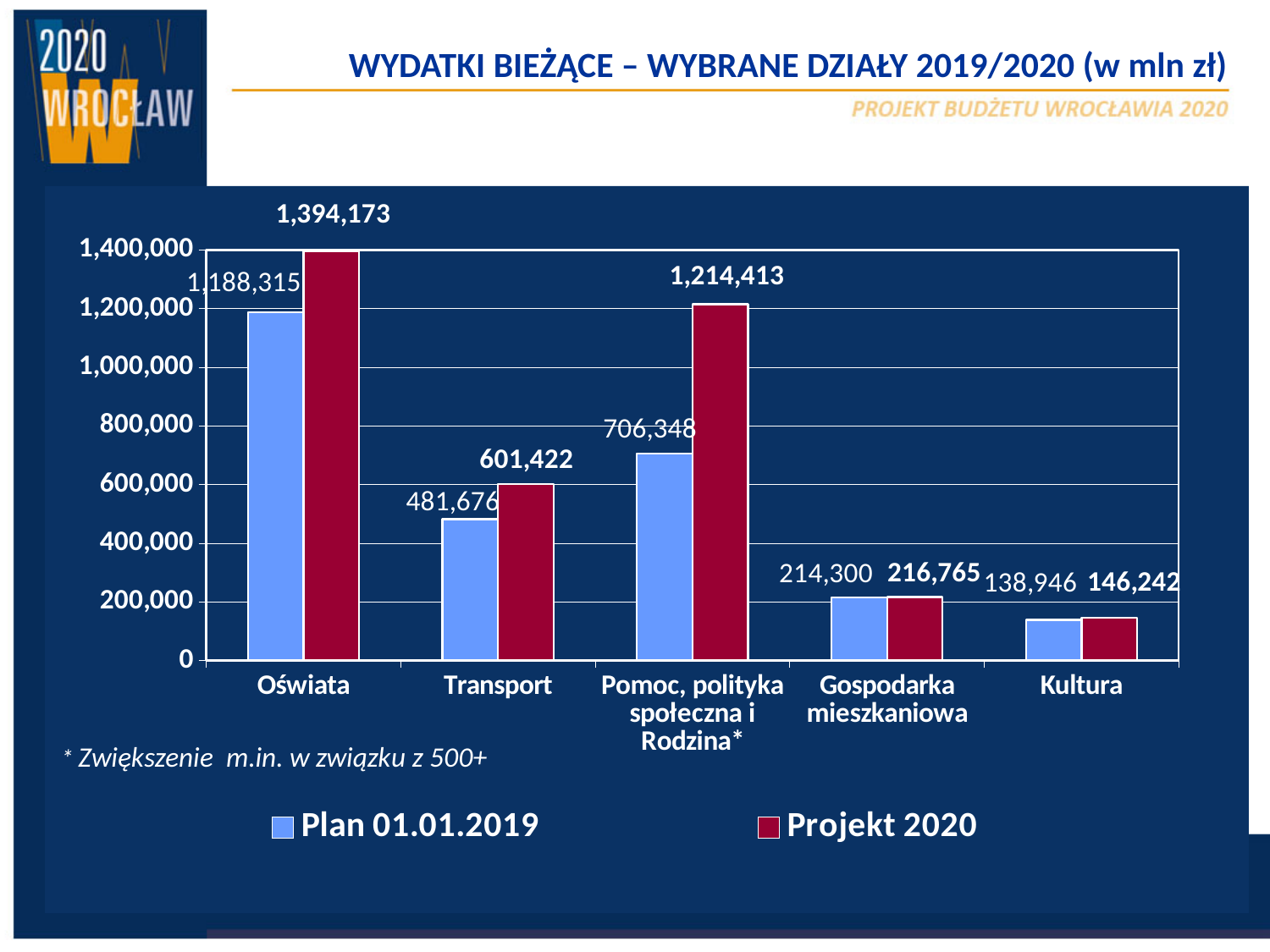
What is the difference between the Projekt 2020 and Plan 01.01.2019 values for Transport? 119,746 How many categories are shown on the x axis? 5 How many series does the legend list? 2 Which category has the highest Projekt 2020 value? Oświata What is the Plan 01.01.2019 value for Transport? 481,676 What kind of chart is shown on the slide? Bar chart What is the Plan 01.01.2019 value for Kultura? 138,946 What is the Projekt 2020 value for Oświata? 1,394,173 What is the Projekt 2020 value for Pomoc, polityka społeczna i Rodzina*? 1,214,413 Which category has the lowest Plan 01.01.2019 value? Kultura Which is larger: the Plan 01.01.2019 value for Transport or the Plan 01.01.2019 value for Pomoc, polityka społeczna i Rodzina*? Pomoc, polityka społeczna i Rodzina* What is the difference between the Projekt 2020 and Plan 01.01.2019 values for Pomoc, polityka społeczna i Rodzina*? 508,065